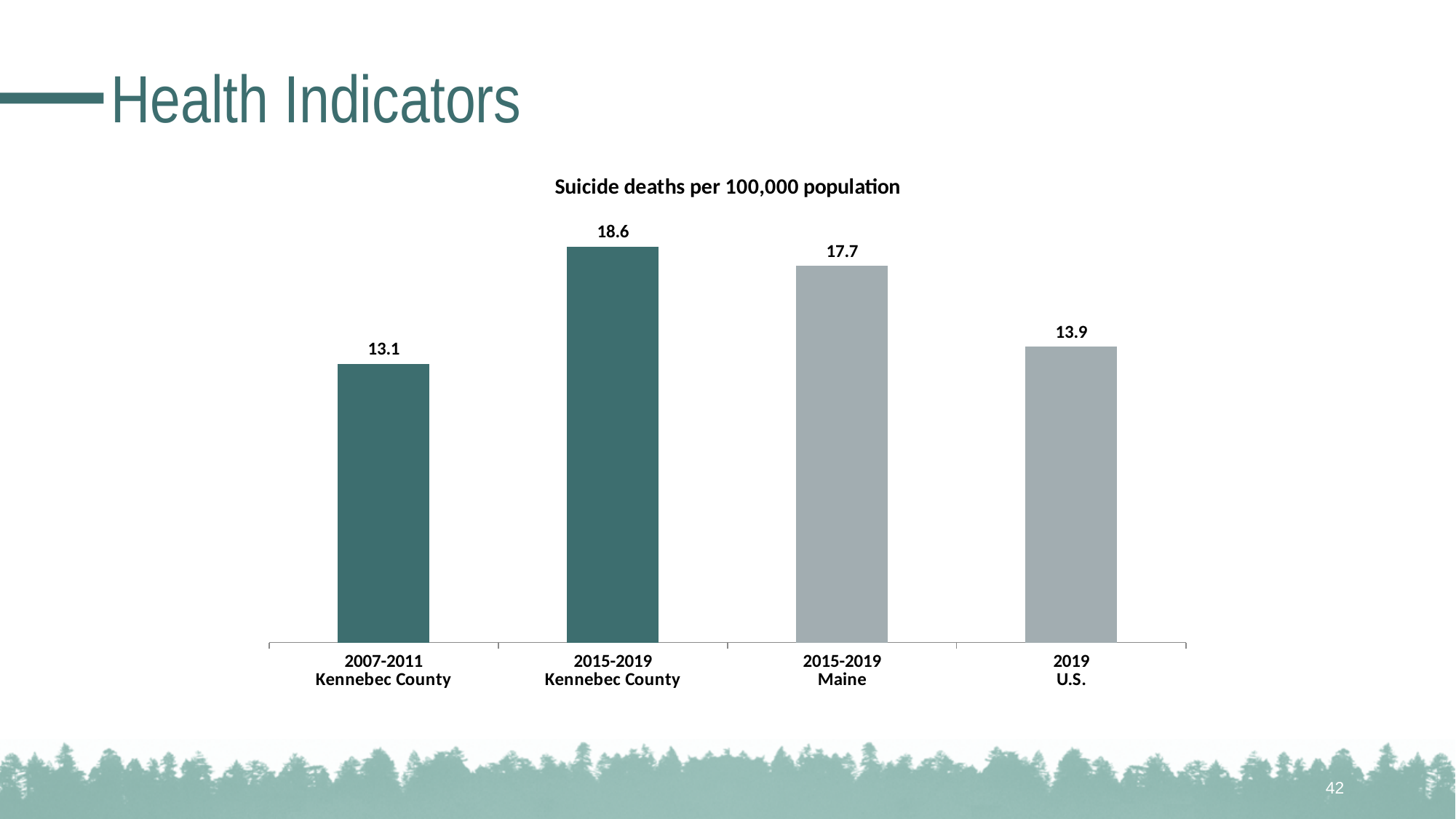
Which category has the lowest value? 2007-2011 Kennebec County What is the value for 2019 U.S.? 13.9 What is the title of the chart? Suicide deaths per 100,000 population What is the difference between the 2015-2019 Maine value and the 2019 U.S. value? 3.8 What is the difference between the 2015-2019 Kennebec County value and the 2007-2011 Kennebec County value? 5.5 Which is larger, the value for 2015-2019 Kennebec County or the value for 2015-2019 Maine? 2015-2019 Kennebec County What is the value for 2015-2019 Maine? 17.7 How many bars are shown in the chart? 4 What kind of chart is shown on the slide? Bar chart What is the value for 2015-2019 Kennebec County? 18.6 What is the value for 2007-2011 Kennebec County? 13.1 Which category has the highest value? 2015-2019 Kennebec County